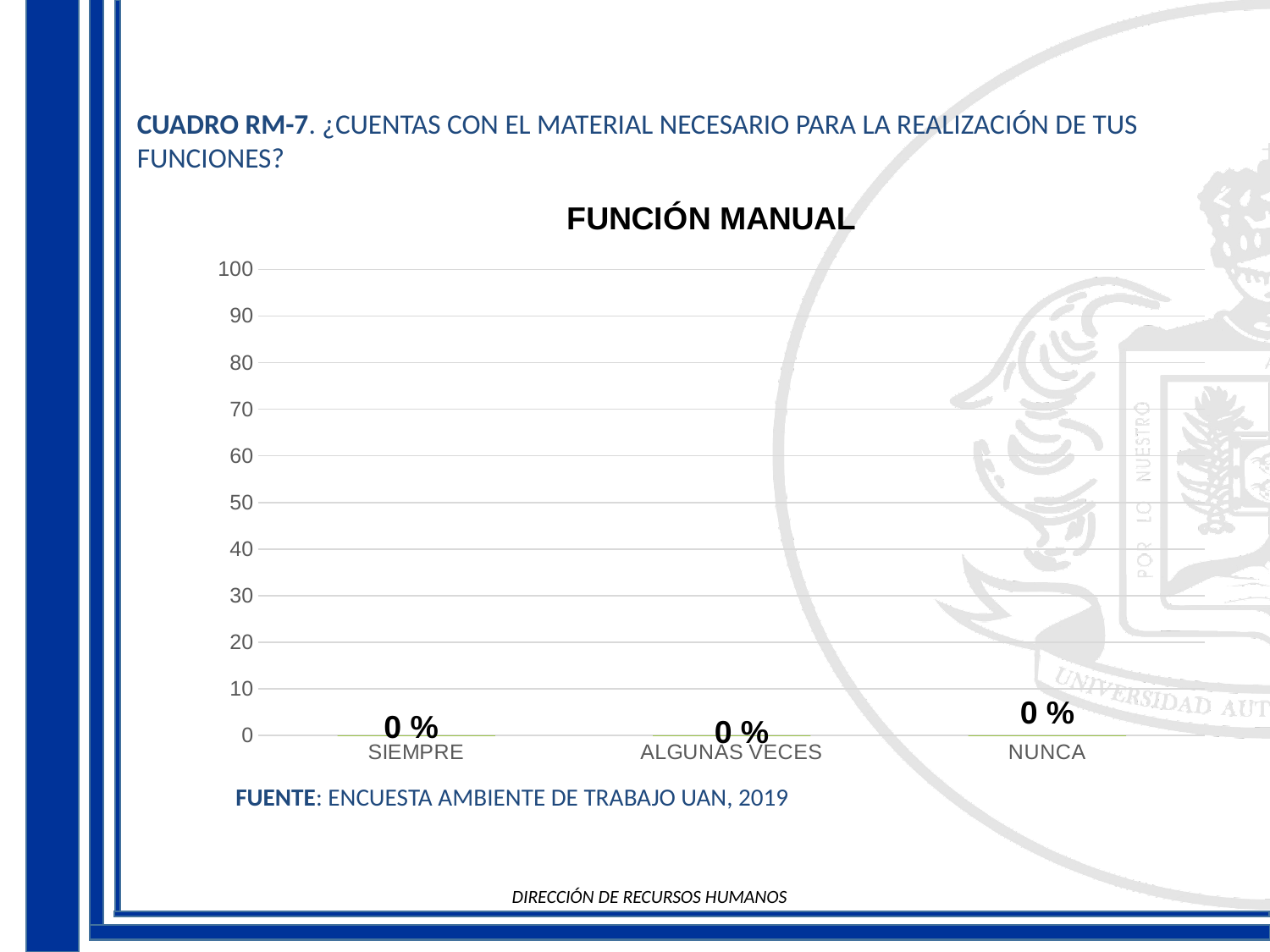
What is the difference between the values for SIEMPRE and NUNCA? 0 % Do all three categories in the chart have the same value? Yes Is the value for ALGUNAS VECES greater or less than 10? less Is the value for NUNCA greater or less than 50? less What is the title of the chart? FUNCIÓN MANUAL What is the value shown for SIEMPRE? 0 % How many categories are shown on the x axis of the chart? 3 What is the value shown for NUNCA? 0 % What is the value shown for ALGUNAS VECES? 0 % What is the highest value shown on the vertical axis of the chart? 100